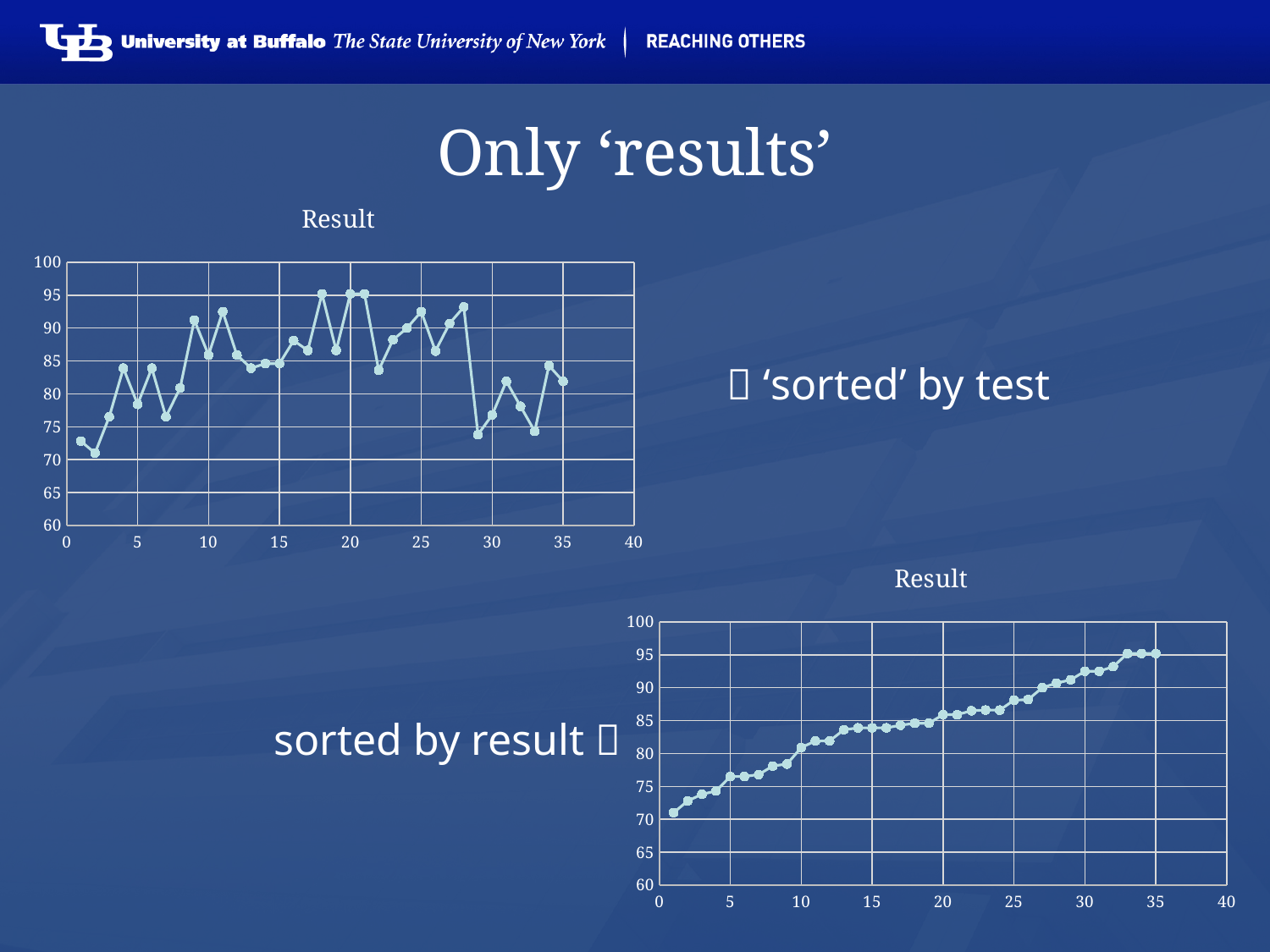
In the bottom-right chart, is the value at x = 35 greater or less than 90? greater In the top-left chart, is the value at x = 29 greater or less than 80? less In the bottom-right chart, do the values rise or fall as the x axis increases? rise In the bottom-right chart, at which x value is the lowest point? 1 In the bottom-right chart, is the value at x = 30 greater or less than 90? greater What is the title shown above each of the two charts? Result In the top-left chart, which is larger: the value at x = 11 or the value at x = 13? x = 11 In the top-left chart, at which x value is the lowest point? 2 What kind of chart is the top-left chart titled 'Result'? line chart